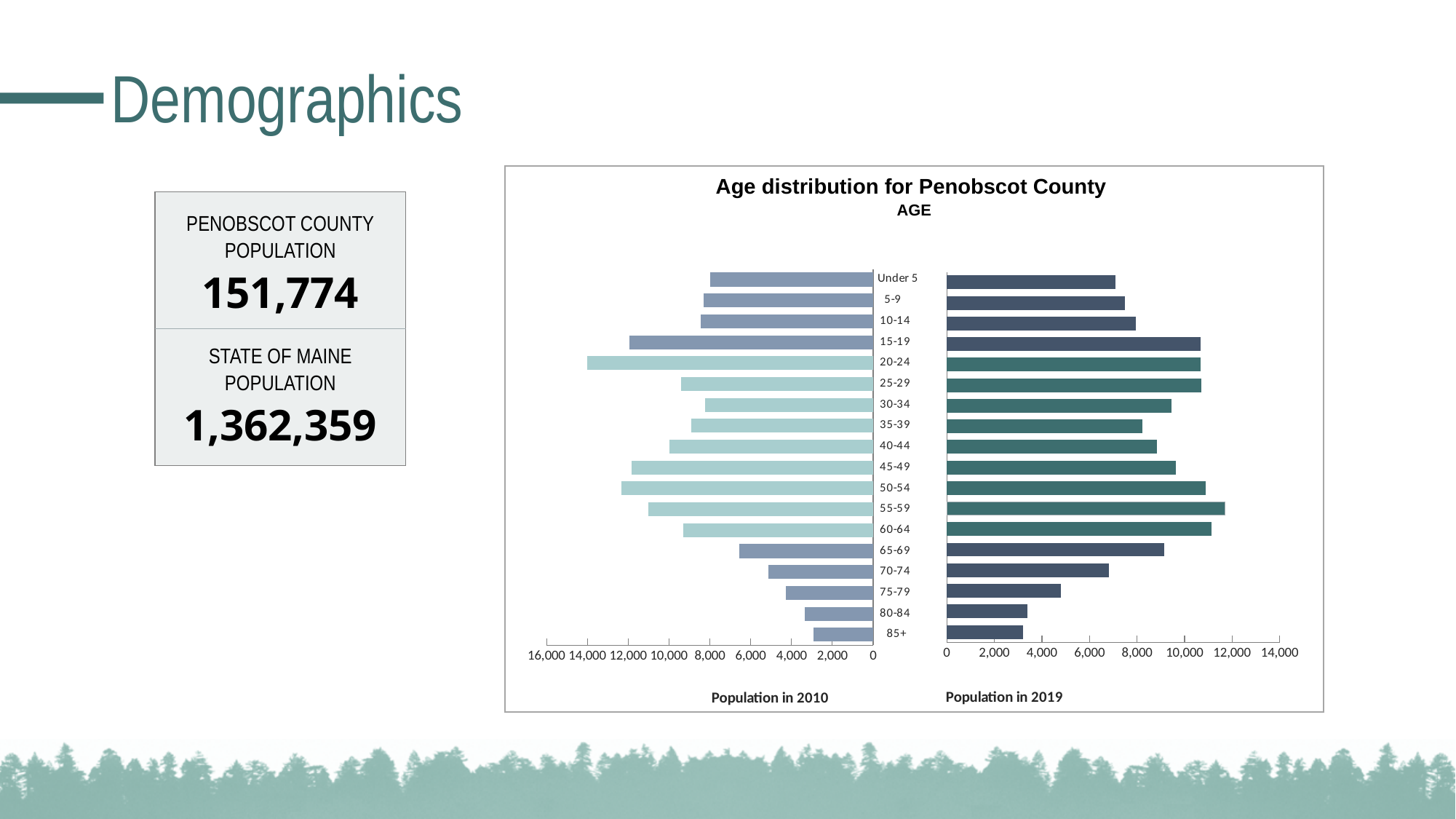
Is the 2019 population for the Under 5 age group greater or less than 8,000? less How many age groups are plotted in the chart? 18 Is the 2019 population for the 55-59 age group greater or less than 10,000? greater Which two populations does the chart compare, as labelled below the axes? Population in 2010 and Population in 2019 Which age group has the smallest population in 2010? 85+ Is the 2010 population for the 20-24 age group greater or less than 12,000? greater In the 2019 series, do the values rise or fall from the 65-69 age group to the 85+ age group? fall What kind of chart is shown on the slide? Bar chart Which age group has the largest population in 2010? 20-24 Which is larger: the 2010 population for the 20-24 age group or the 2019 population for the 20-24 age group? 2010 What is the title of the chart? Age distribution for Penobscot County Which age group has the largest population in 2019? 55-59